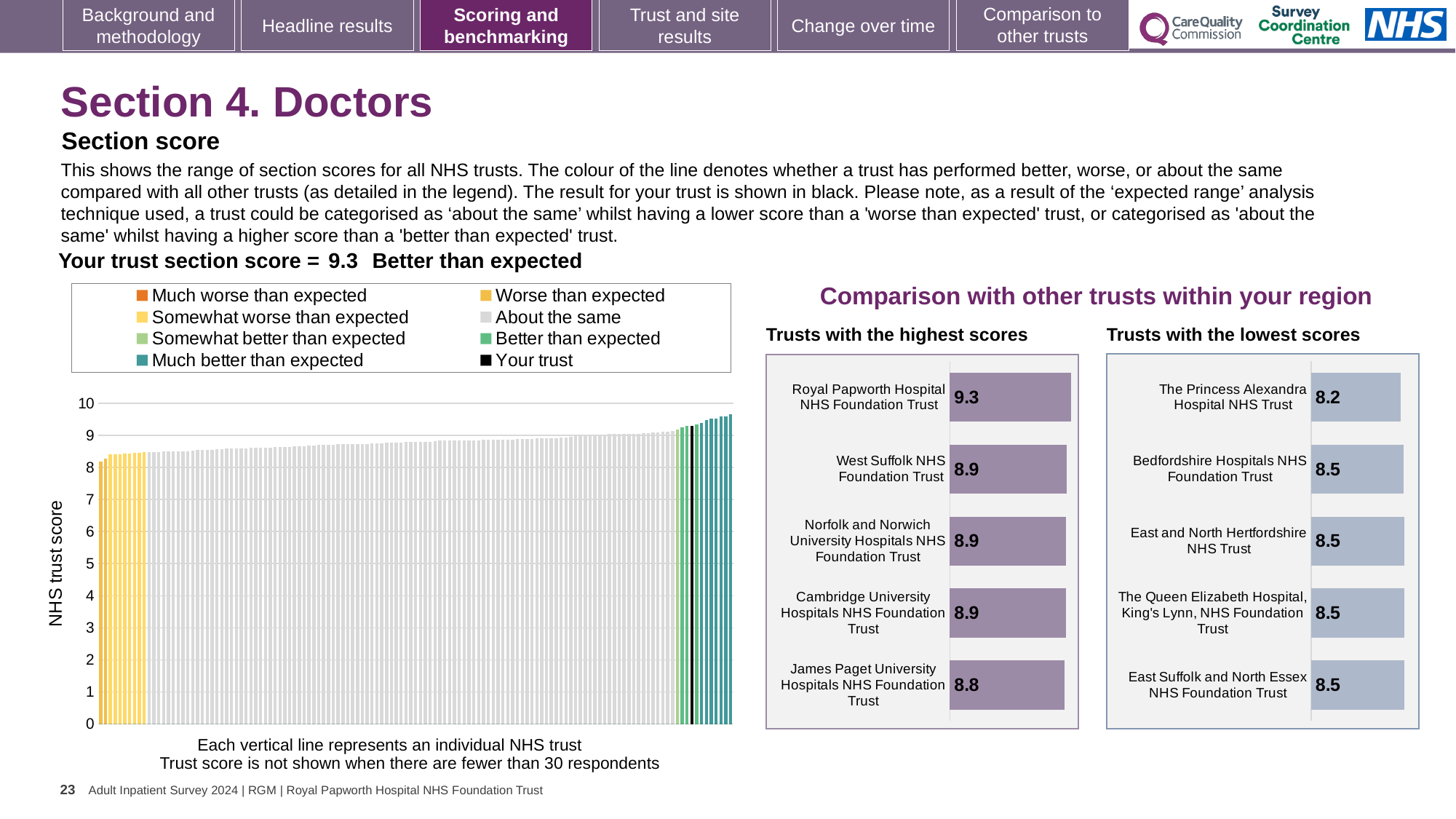
How many trusts are listed in the 'Trusts with the highest scores' chart? 5 In the 'Trusts with the lowest scores' chart, what is the difference between the scores of Bedfordshire Hospitals NHS Foundation Trust and The Princess Alexandra Hospital NHS Trust? 0.3 In the 'Trusts with the lowest scores' chart, what is the score for The Princess Alexandra Hospital NHS Trust? 8.2 In the 'Trusts with the highest scores' chart, what is the score for James Paget University Hospitals NHS Foundation Trust? 8.8 In the 'Trusts with the lowest scores' chart, which trust has the lowest score? The Princess Alexandra Hospital NHS Trust Which is larger: the score for West Suffolk NHS Foundation Trust in the 'Trusts with the highest scores' chart or the score for East Suffolk and North Essex NHS Foundation Trust in the 'Trusts with the lowest scores' chart? West Suffolk NHS Foundation Trust In the 'Trusts with the highest scores' chart, which trust has the highest score? Royal Papworth Hospital NHS Foundation Trust What kind of chart is the large 'NHS trust score' chart on the left of the slide? Bar chart How many entries does the legend of the large 'NHS trust score' chart on the left list? 8 In the large 'NHS trust score' chart on the left, do the bars rise or fall from left to right? Rise In the 'Trusts with the highest scores' chart, what is the score for Royal Papworth Hospital NHS Foundation Trust? 9.3 In the 'Trusts with the highest scores' chart, what is the difference between the scores of Royal Papworth Hospital NHS Foundation Trust and James Paget University Hospitals NHS Foundation Trust? 0.5